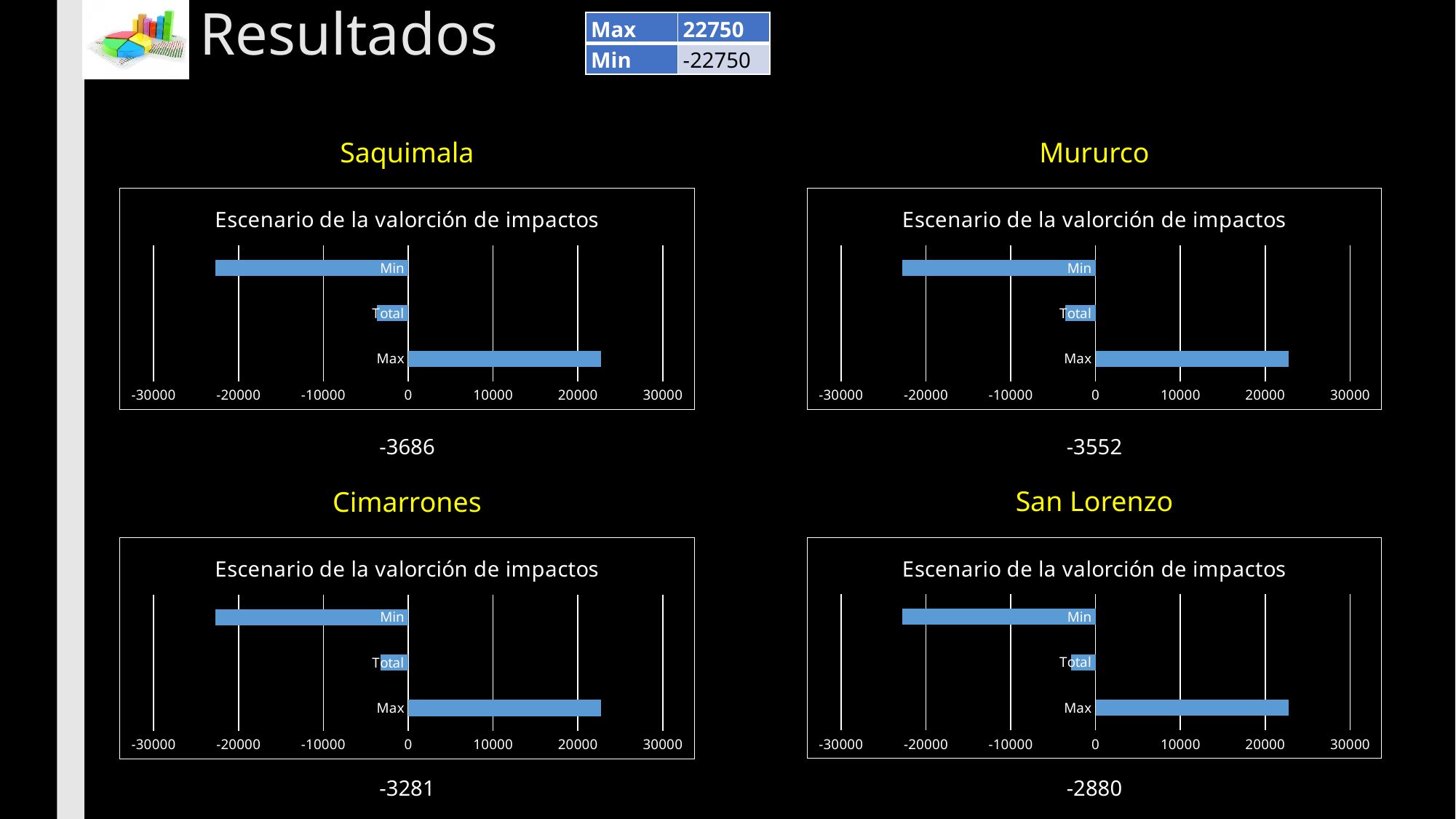
In the Mururco chart, which category has the highest value? Max In the Saquimala chart, which is larger, the value for Max or the value for Total? Max In the Mururco chart, is the value for Min greater or less than -20000? less In the Saquimala chart, which category has the lowest value? Min How many charts are shown on the slide? 4 In the Saquimala chart, is the value for Max greater or less than 20000? greater What kind of chart is the Saquimala chart? bar chart In the Saquimala chart, how many categories are plotted? 3 In the San Lorenzo chart, is the value for Max greater or less than 30000? less What heading appears above the top-right chart? Mururco What is the title shown inside the Cimarrones chart? Escenario de la valorción de impactos